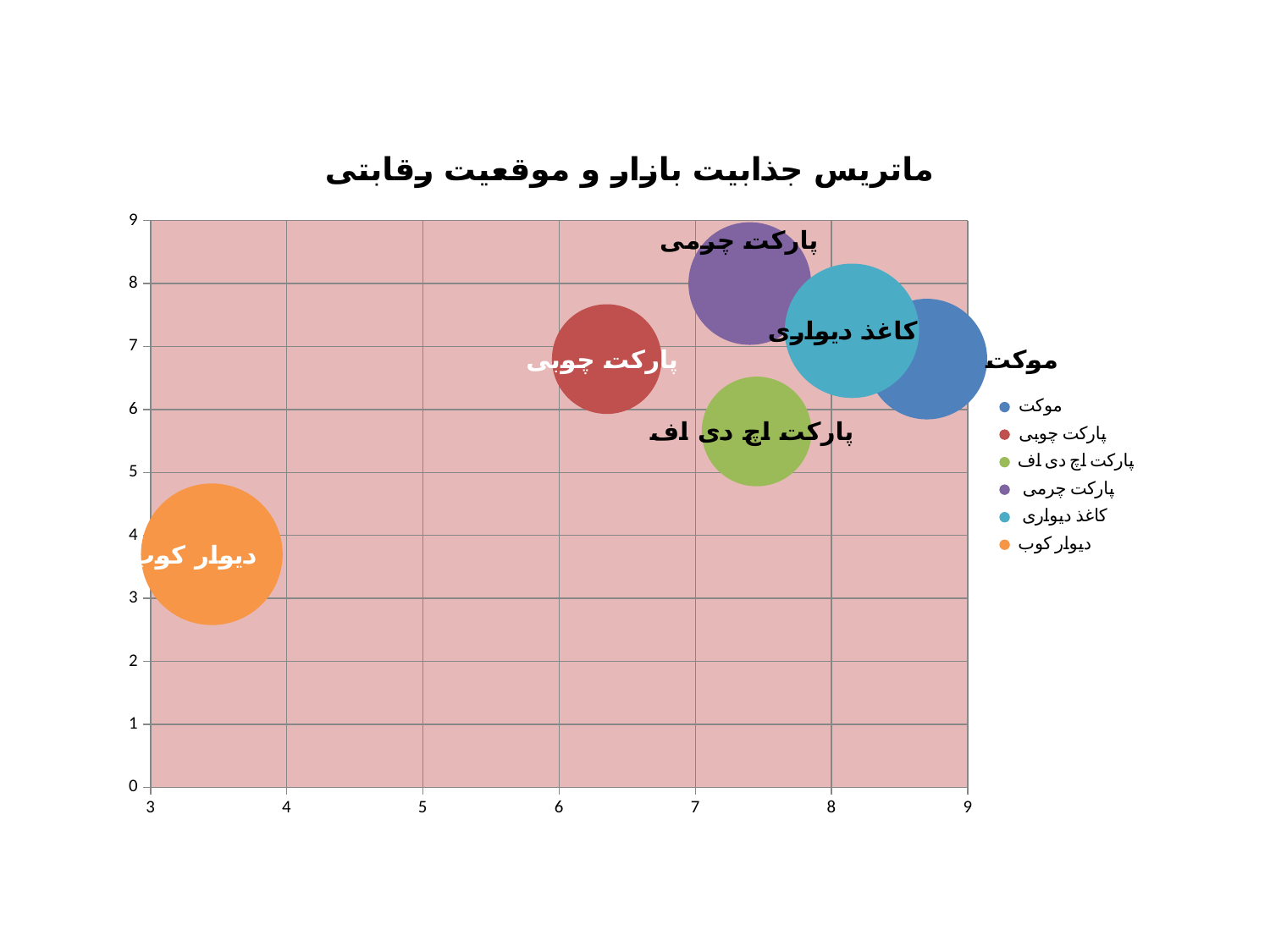
Which is higher on the vertical axis, پارکت چرمی or پارکت اچ دی اف? پارکت چرمی How many series does the legend list? 6 Which bubble is furthest to the right on the horizontal axis? موکت What kind of chart is shown on the slide? Bubble chart What is the title of the chart? ماتریس جذابیت بازار و موقعیت رقابتی How many bubbles are plotted on the chart? 6 Which bubble is highest on the vertical axis? پارکت چرمی Is the vertical-axis value for دیوار کوب greater or less than 5? less Which bubble is lowest on the vertical axis? دیوار کوب Is the horizontal-axis value for موکت greater or less than 8? greater Which bubble is furthest to the left on the horizontal axis? دیوار کوب Is the horizontal-axis value for پارکت چوبی greater or less than 7? less